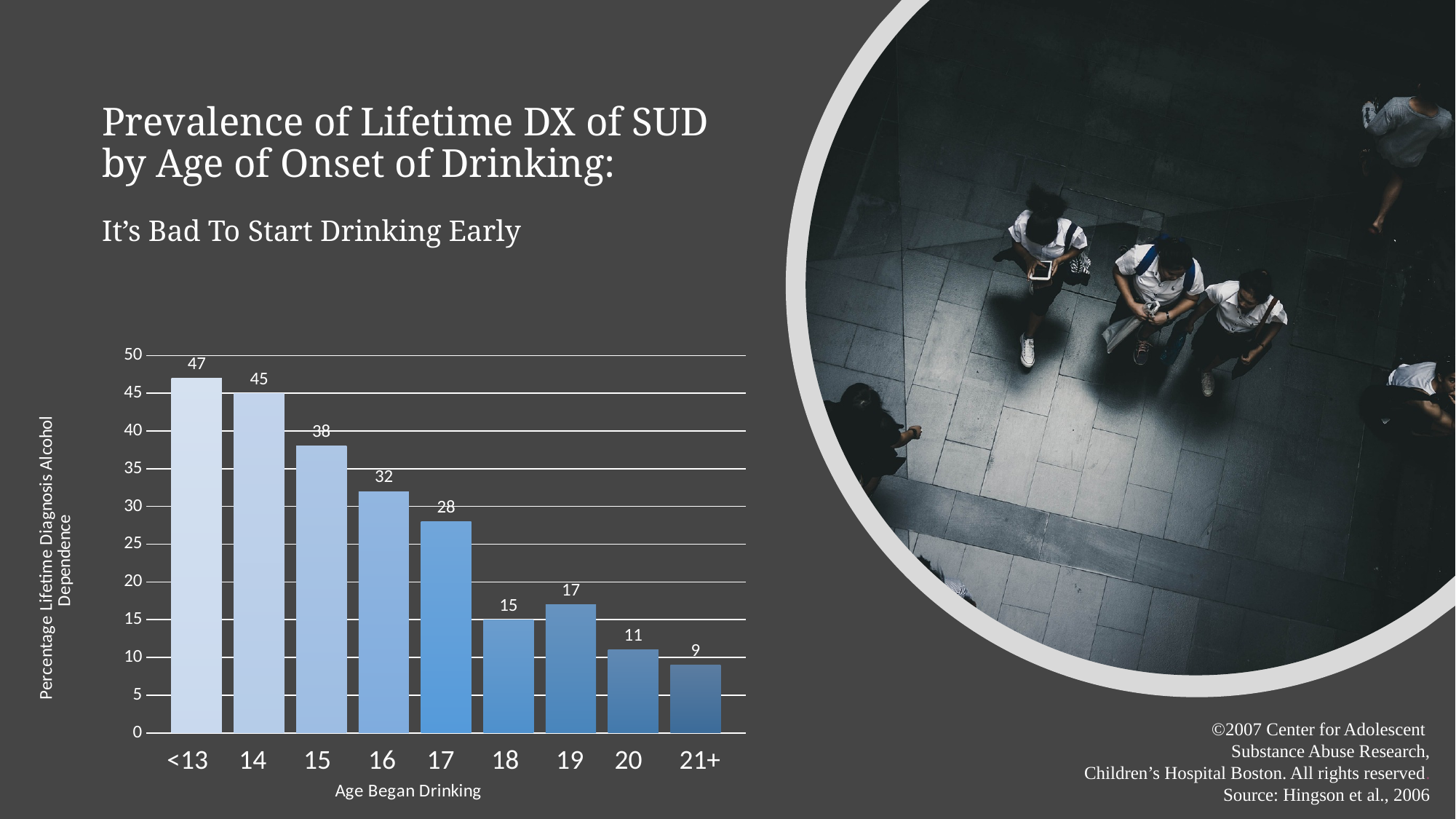
Which has a higher value, age 18 or age 19? 19 What is the difference between the values for age 14 and age 15? 7 What is the label of the x axis? Age Began Drinking What kind of chart is shown on the slide? Bar chart Is the value for age 17 greater or less than 25? greater What is the difference between the values for <13 and 21+? 38 What is the percentage with lifetime diagnosis of alcohol dependence for those who began drinking at age 16? 32 What is the value shown for the <13 age group? 47 What is the value shown for the 21+ age group? 9 How many age categories are shown on the x axis? 9 Which age of onset category has the lowest percentage? 21+ Which age of onset category has the highest percentage? <13